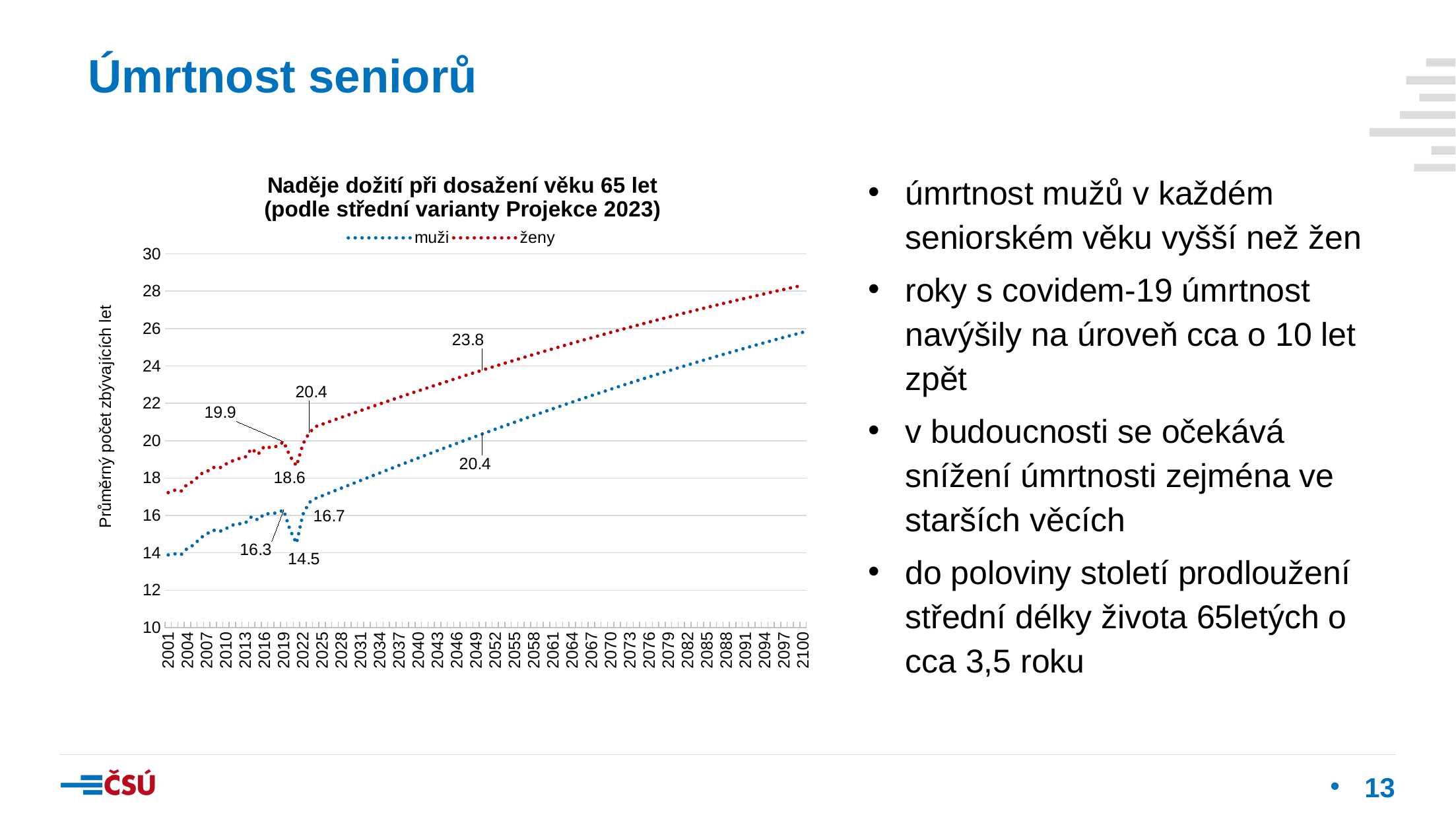
What is the highest labelled value shown on the muži series? 20.4 What is the difference between the labelled values 23.8 (ženy) and 20.4 (muži) around the middle of the century? 3.4 What is the lowest labelled value on the ženy series (at the covid-era dip)? 18.6 Which series lies higher across the whole chart, muži or ženy? ženy What is the highest labelled value shown on the ženy series? 23.8 Is the value for muži in 2100 greater or less than 24? greater By how much did the ženy series fall from the labelled value 19.9 to the labelled dip value 18.6? 1.3 How many series does the chart legend list? 2 By how much did the muži series fall from the labelled value 16.3 to the labelled dip value 14.5? 1.8 What are the two series named in the chart legend? muži and ženy What is the lowest labelled value on the muži series (at the covid-era dip)? 14.5 What kind of chart is shown on the slide? line chart